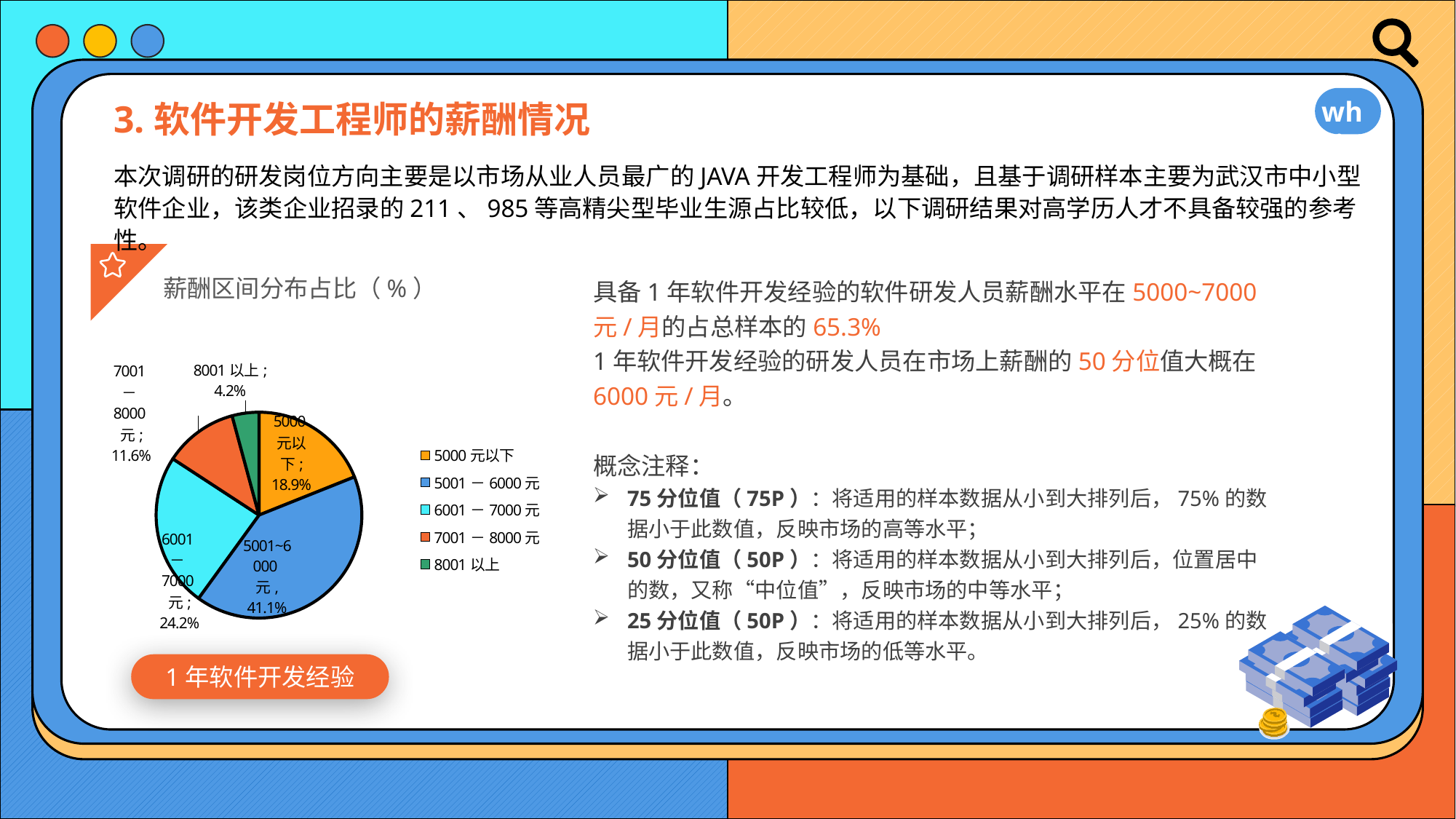
What is the difference between the shares for 5001－6000元 and 6001－7000元? 16.9% Which salary range has the smallest share of the pie? 8001以上 Which is larger, the share for 5000元以下 or the share for 7001－8000元? 5000元以下 Which salary range has the largest share of the pie? 5001－6000元 How many slices does the pie chart have? 5 What is the value for 6001－7000元? 24.2% What type of chart is shown on the slide? pie chart What is the value for 5000元以下? 18.9% What is the value for 7001－8000元? 11.6% What share of the pie does the 5001－6000元 slice represent? 41.1% What is the title of the chart? 薪酬区间分布占比（%） What is the value for 8001以上? 4.2%